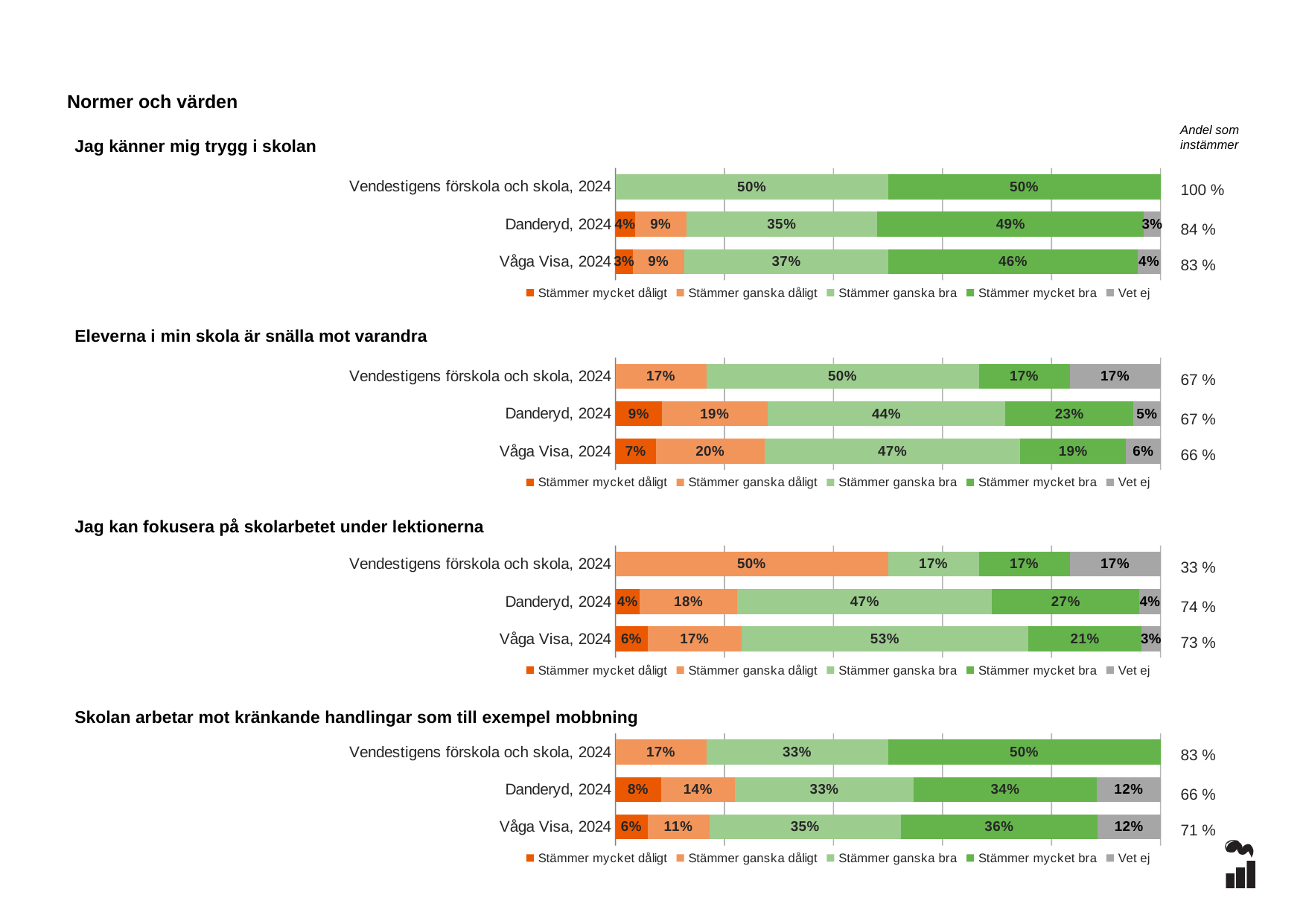
In the chart 'Eleverna i min skola är snälla mot varandra', which row has the lowest 'Andel som instämmer'? Våga Visa, 2024 How many series does the legend list for the chart 'Jag känner mig trygg i skolan'? 5 In the chart 'Skolan arbetar mot kränkande handlingar som till exempel mobbning', what is the 'Andel som instämmer' for Våga Visa, 2024? 71 % In the chart 'Jag kan fokusera på skolarbetet under lektionerna', what is the difference in 'Andel som instämmer' between Danderyd, 2024 and Vendestigens förskola och skola, 2024? 41 % In the chart 'Jag känner mig trygg i skolan', what is the 'Andel som instämmer' for Vendestigens förskola och skola, 2024? 100 % In the chart 'Skolan arbetar mot kränkande handlingar som till exempel mobbning', which row has the highest 'Stämmer mycket bra' value? Vendestigens förskola och skola, 2024 How many rows (categories) are shown in the chart 'Eleverna i min skola är snälla mot varandra'? 3 What kind of chart is used for 'Jag kan fokusera på skolarbetet under lektionerna'? Stacked horizontal bar chart In the chart 'Jag känner mig trygg i skolan', what is the 'Stämmer mycket bra' value for Danderyd, 2024? 49% In the chart 'Jag kan fokusera på skolarbetet under lektionerna', what is the 'Stämmer ganska dåligt' value for Vendestigens förskola och skola, 2024? 50% In the chart 'Skolan arbetar mot kränkande handlingar som till exempel mobbning', is the 'Stämmer ganska bra' value larger for Våga Visa, 2024 or Danderyd, 2024? Våga Visa, 2024 In the chart 'Eleverna i min skola är snälla mot varandra', what is the 'Vet ej' value for Vendestigens förskola och skola, 2024? 17%